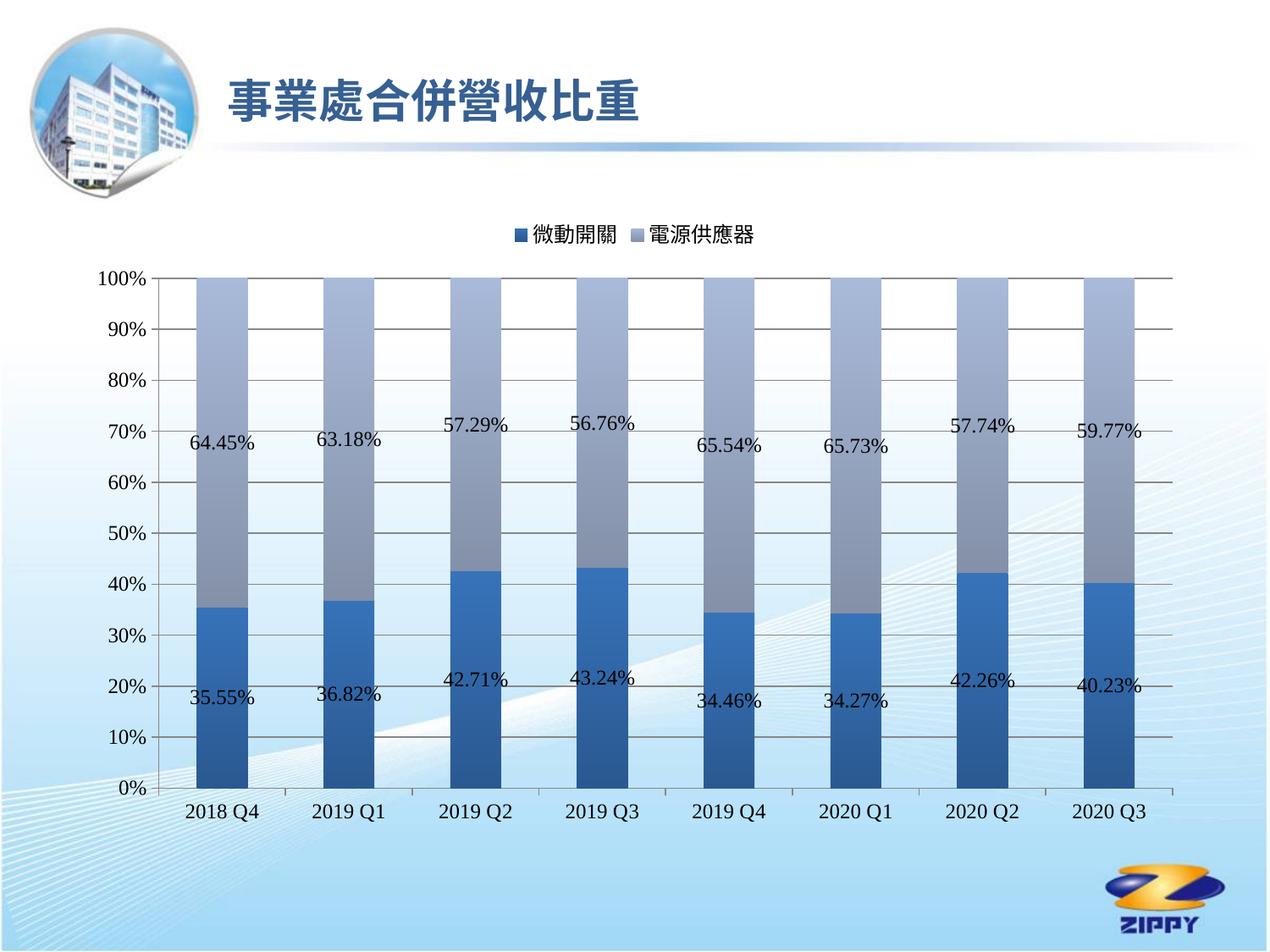
What is the value for 微動開關 in 2020 Q3? 40.23% What is the difference between the 電源供應器 share and the 微動開關 share in 2018 Q4? 28.90% What kind of chart is shown on the slide? Stacked bar chart What is the value for 電源供應器 in 2020 Q1? 65.73% What is the title of the slide? 事業處合併營收比重 Which is larger in 2020 Q2: the 微動開關 share or the 電源供應器 share? 電源供應器 How many quarters are shown on the x axis? 8 In which quarter is the 微動開關 share lowest? 2020 Q1 How many series does the legend list? 2 In which quarter is the 微動開關 share highest? 2019 Q3 What is the value for 微動開關 in 2019 Q3? 43.24% In which quarter is the 電源供應器 share lowest? 2019 Q3